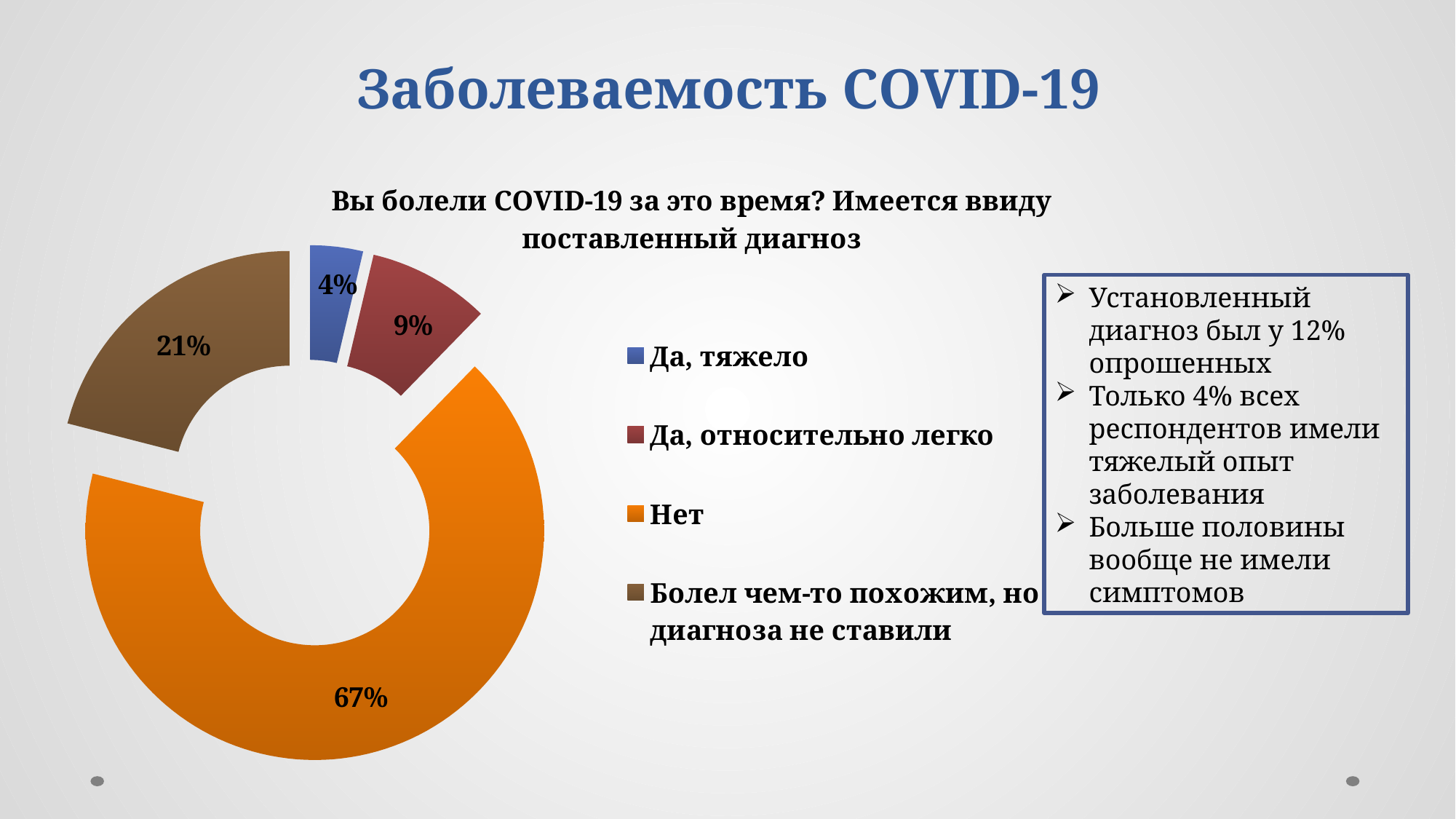
What share of respondents answered "Да, тяжело"? 4% What share of respondents answered "Нет"? 67% Which is larger: the share for "Да, относительно легко" or the share for "Да, тяжело"? Да, относительно легко What kind of chart is shown on the slide? Pie chart (doughnut) Which answer category has the smallest share of the pie? Да, тяжело What share of respondents answered "Да, относительно легко"? 9% What share of respondents answered "Болел чем-то похожим, но диагноза не ставили"? 21% What colour is the slice for "Нет"? Orange What is the difference in percentage points between "Нет" and "Болел чем-то похожим, но диагноза не ставили"? 46 How many categories does the chart show? 4 Which answer category has the largest share of the pie? Нет